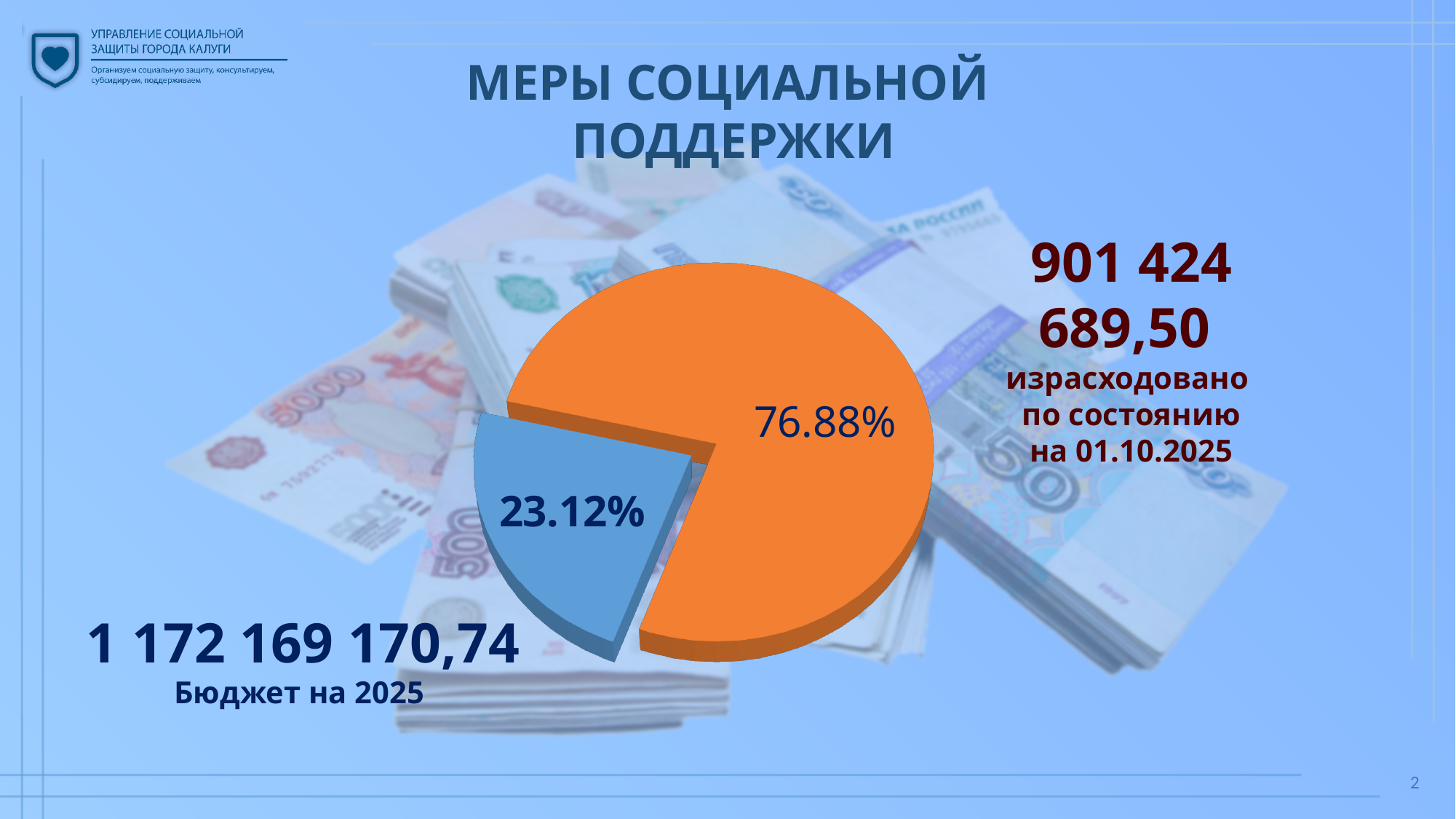
How many slices does the pie chart have? 2 What percentage is shown on the orange slice of the pie chart? 76.88% Is the share of the blue slice in the pie chart greater or less than 25%? less Which slice of the pie chart is the largest? the orange slice (76.88%) What amount is shown on the slide as the budget for 2025 (Бюджет на 2025)? 1 172 169 170,74 Which is larger in the pie chart, the orange slice or the blue slice? the orange slice What is the title of the slide containing the pie chart? МЕРЫ СОЦИАЛЬНОЙ ПОДДЕРЖКИ What is the difference in percentage points between the orange slice and the blue slice of the pie chart? 53.76 What kind of chart is shown on the slide? pie chart What percentage is shown on the blue slice of the pie chart? 23.12% Which slice of the pie chart is the smallest? the blue slice (23.12%)